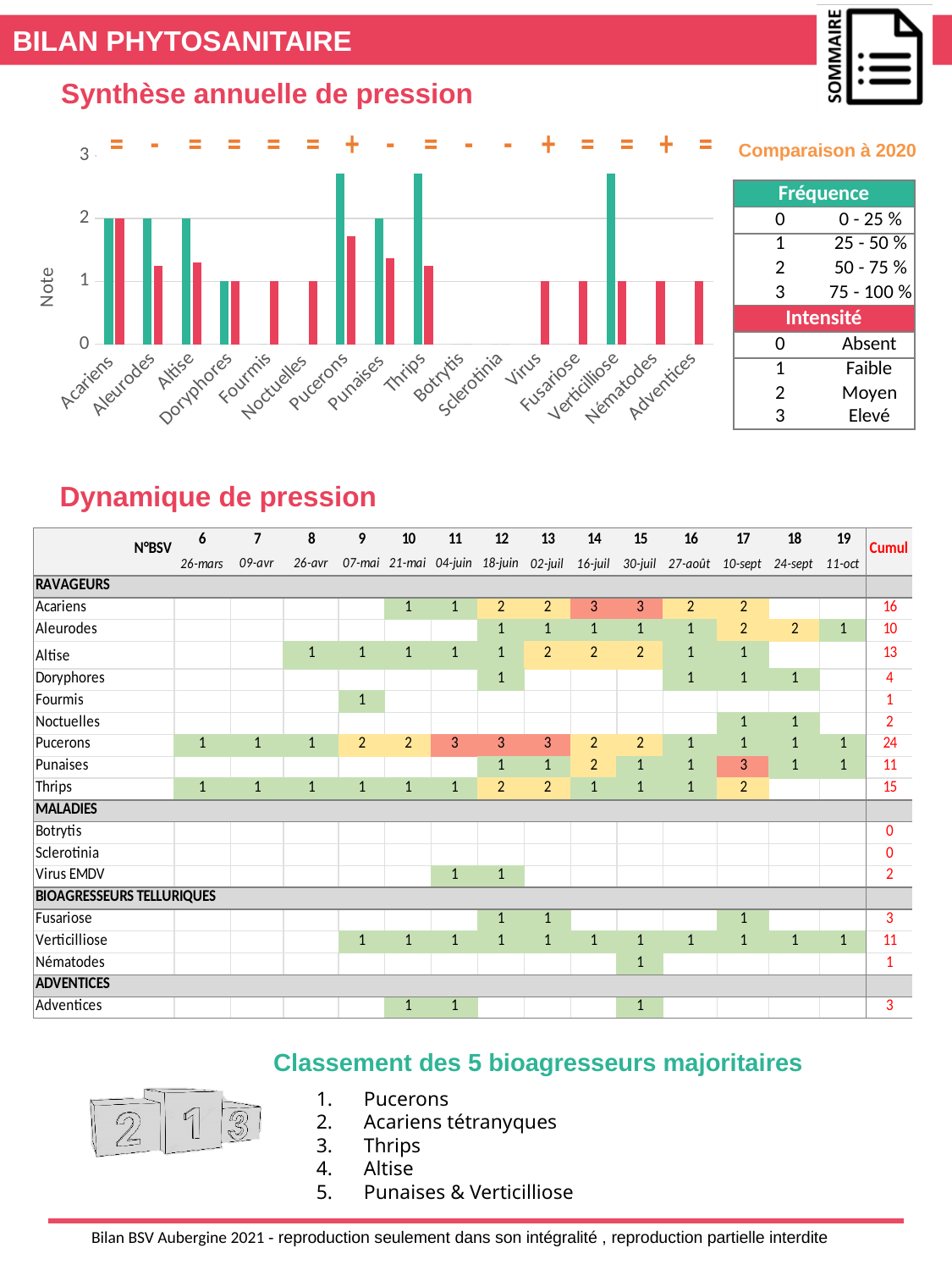
In the 'Synthèse annuelle de pression' chart, what is the value of the red bar for Doryphores? 1 In the 'Synthèse annuelle de pression' chart, what is the value of the red bar for Nématodes? 1 In the 'Synthèse annuelle de pression' chart, which is larger: the green bar for Thrips or the green bar for Punaises? Thrips In the 'Synthèse annuelle de pression' chart, which is larger: the red bar for Acariens or the red bar for Aleurodes? Acariens In the 'Synthèse annuelle de pression' chart, what is the value of the green bar for Acariens? 2 In the 'Synthèse annuelle de pression' chart, is the red bar for Aleurodes greater or less than 2? less In the 'Synthèse annuelle de pression' chart, is the green bar for Pucerons greater or less than 2? greater In the 'Synthèse annuelle de pression' chart, how many categories are shown on the x axis? 16 In the 'Synthèse annuelle de pression' chart, what is the label of the y axis? Note In the 'Synthèse annuelle de pression' chart, which category has the highest red bar? Acariens In the 'Synthèse annuelle de pression' chart, what is the highest value shown on the y axis? 3 What kind of chart is shown under 'Synthèse annuelle de pression'? bar chart